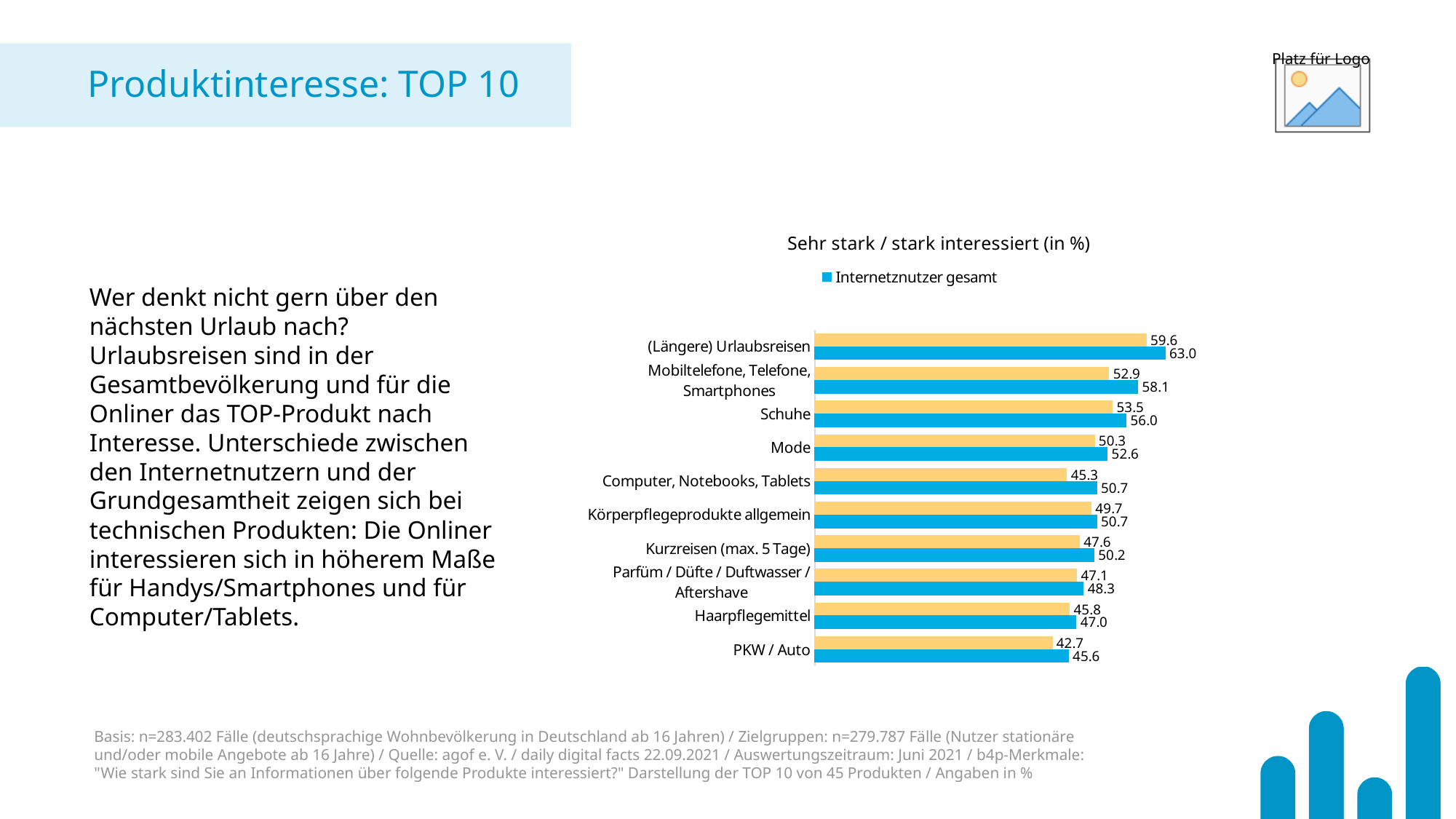
What is the value for Internetznutzer gesamt for (Längere) Urlaubsreisen? 63.0 Which is larger for Internetznutzer gesamt: Kurzreisen (max. 5 Tage) or Haarpflegemittel? Kurzreisen (max. 5 Tage) What is the difference between the Internetznutzer gesamt values for (Längere) Urlaubsreisen and Mode? 10.4 Which category has the highest value for Internetznutzer gesamt? (Längere) Urlaubsreisen What kind of chart is shown on the slide? bar chart What is the difference between the Internetznutzer gesamt value and the yellow bar value for Mobiltelefone, Telefone, Smartphones? 5.2 What is the title of the chart? Sehr stark / stark interessiert (in %) How many series does the legend list? 1 How many product categories are shown in the chart? 10 What is the value for Internetznutzer gesamt for PKW / Auto? 45.6 Which category has the lowest value of the yellow bars? PKW / Auto What is the value of the yellow bar for Schuhe? 53.5